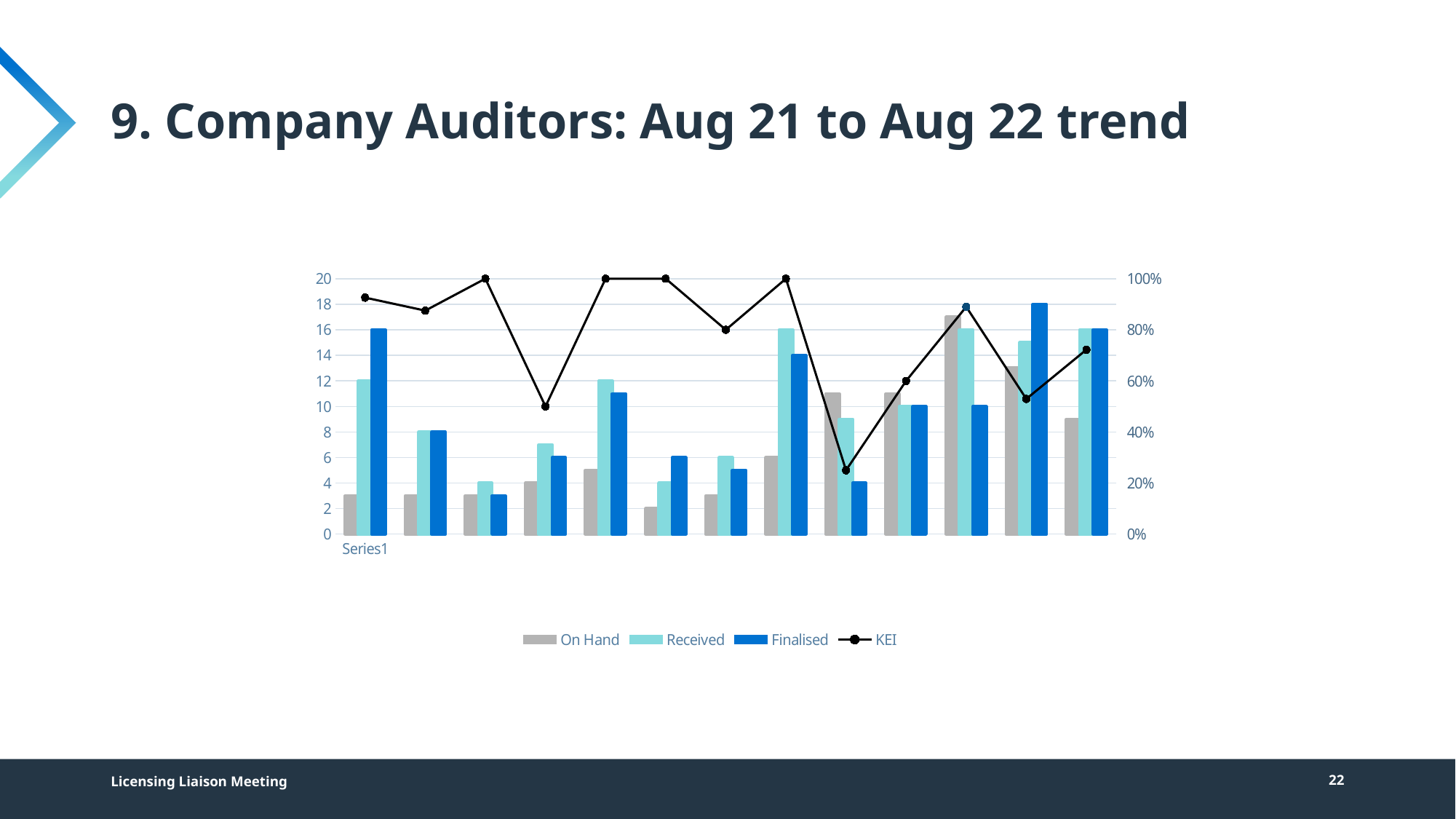
For Series1, which is larger, Received or Finalised? Finalised What is the highest value reached by the Finalised series? 18 How many groups of bars are plotted along the x axis? 13 What kind of chart is shown on the slide? A combined bar and line chart Is the On Hand value for Series1 greater or less than 4? less Which series is drawn as a line rather than bars? KEI What is the Finalised value for Series1? 16 For Series1, what is the difference between the Finalised and Received values? 4 What is the Received value for Series1? 12 Is the KEI value for Series1 greater or less than 80%? greater How many KEI points reach 100%? 4 How many series does the legend list? 4